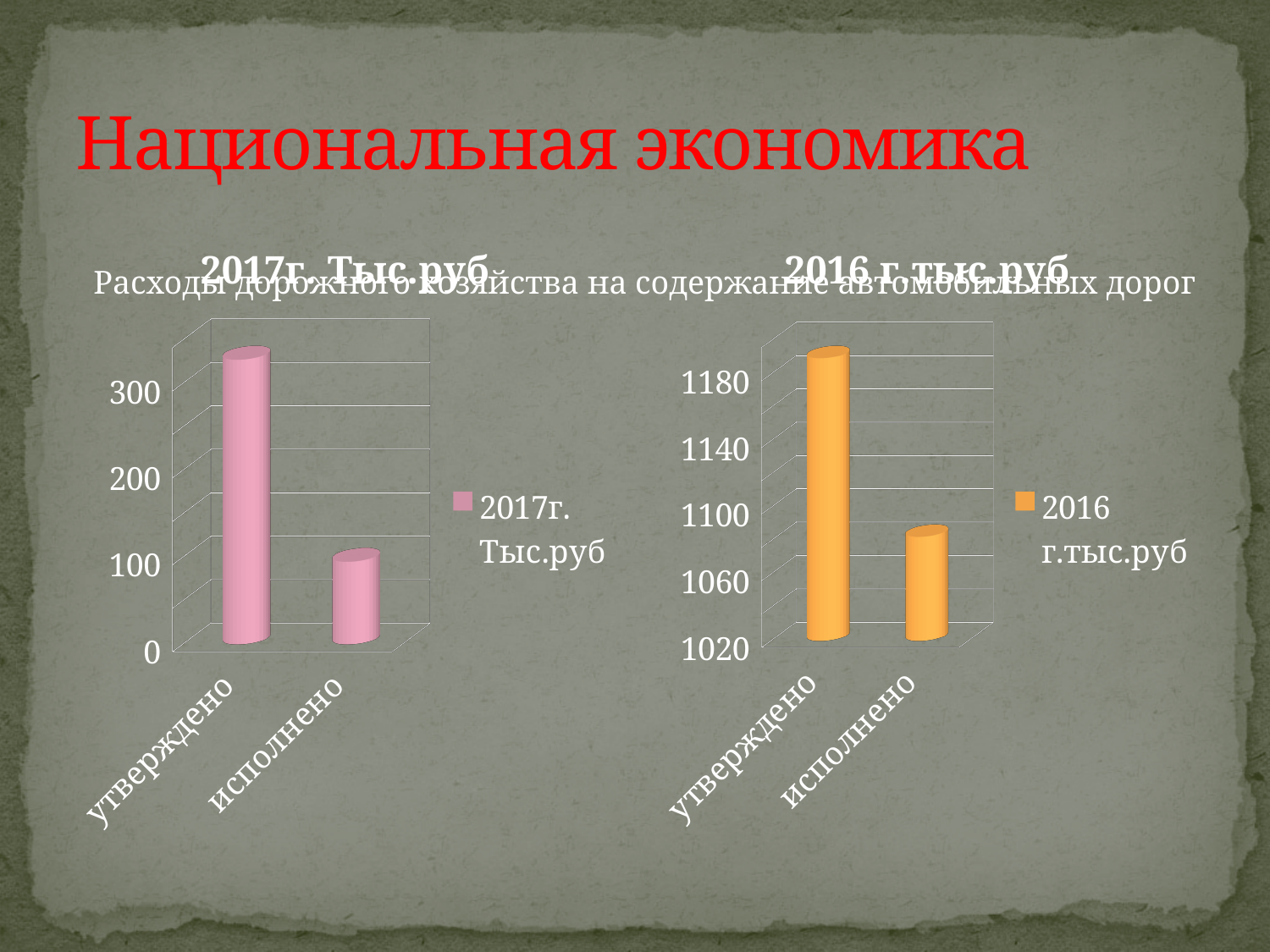
In the left chart titled "2017г. Тыс.руб", how many series does the legend list? 1 In the right chart titled "2016 г. тыс.руб", is the value for утверждено greater or less than 1180? greater In the left chart titled "2017г. Тыс.руб", is the value for утверждено greater or less than 300? greater In the left chart titled "2017г. Тыс.руб", is the value for исполнено greater or less than 200? less In the left chart titled "2017г. Тыс.руб", which category has the highest value? утверждено In the left chart titled "2017г. Тыс.руб", what kind of chart is shown? bar chart What is the legend entry of the right chart? 2016 г.тыс.руб In the left chart titled "2017г. Тыс.руб", do the values rise or fall from утверждено to исполнено? fall In the right chart titled "2016 г. тыс.руб", how many categories are shown on the x axis? 2 In the right chart titled "2016 г. тыс.руб", which category has the lowest value? исполнено In the right chart titled "2016 г. тыс.руб", which is larger, утверждено or исполнено? утверждено